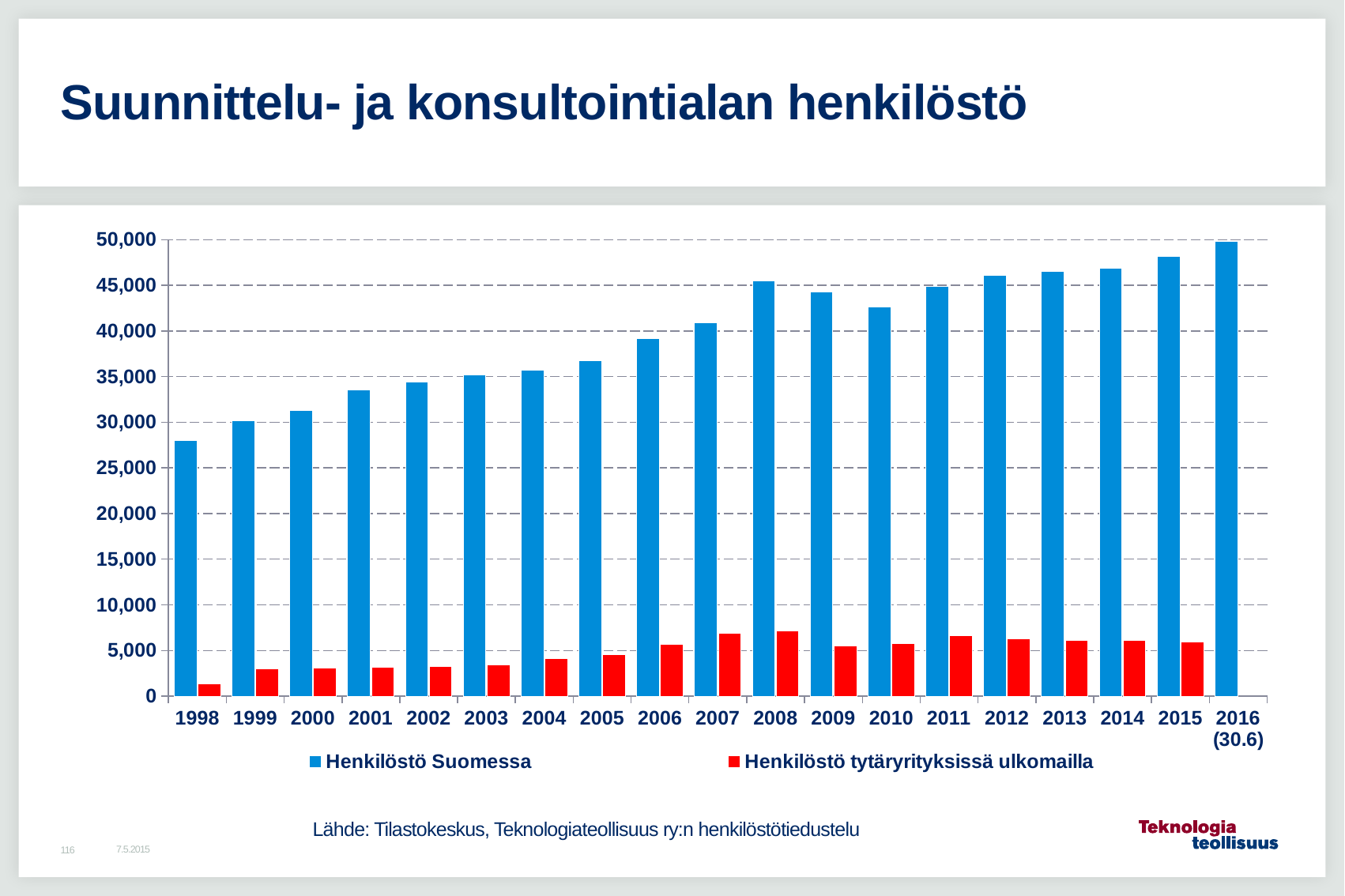
Is the value for Henkilöstö tytäryrityksissä ulkomailla in 2008 greater or less than 5,000? greater Is the value for Henkilöstö Suomessa in 2010 greater or less than 45,000? less Overall, do the values for Henkilöstö Suomessa rise or fall from 1998 to 2016? rise Is the value for Henkilöstö Suomessa in 1998 greater or less than 30,000? less Which year has the lowest value for Henkilöstö Suomessa? 1998 Which is larger, Henkilöstö tytäryrityksissä ulkomailla in 2007 or in 2009? 2007 What kind of chart is shown on the slide? bar chart Which year has the highest value for Henkilöstö Suomessa? 2016 (30.6) Which is larger, Henkilöstö Suomessa in 2008 or in 2010? 2008 Which year has the lowest value for Henkilöstö tytäryrityksissä ulkomailla? 1998 How many series does the legend list? 2 How many years (categories) are shown on the x axis? 19